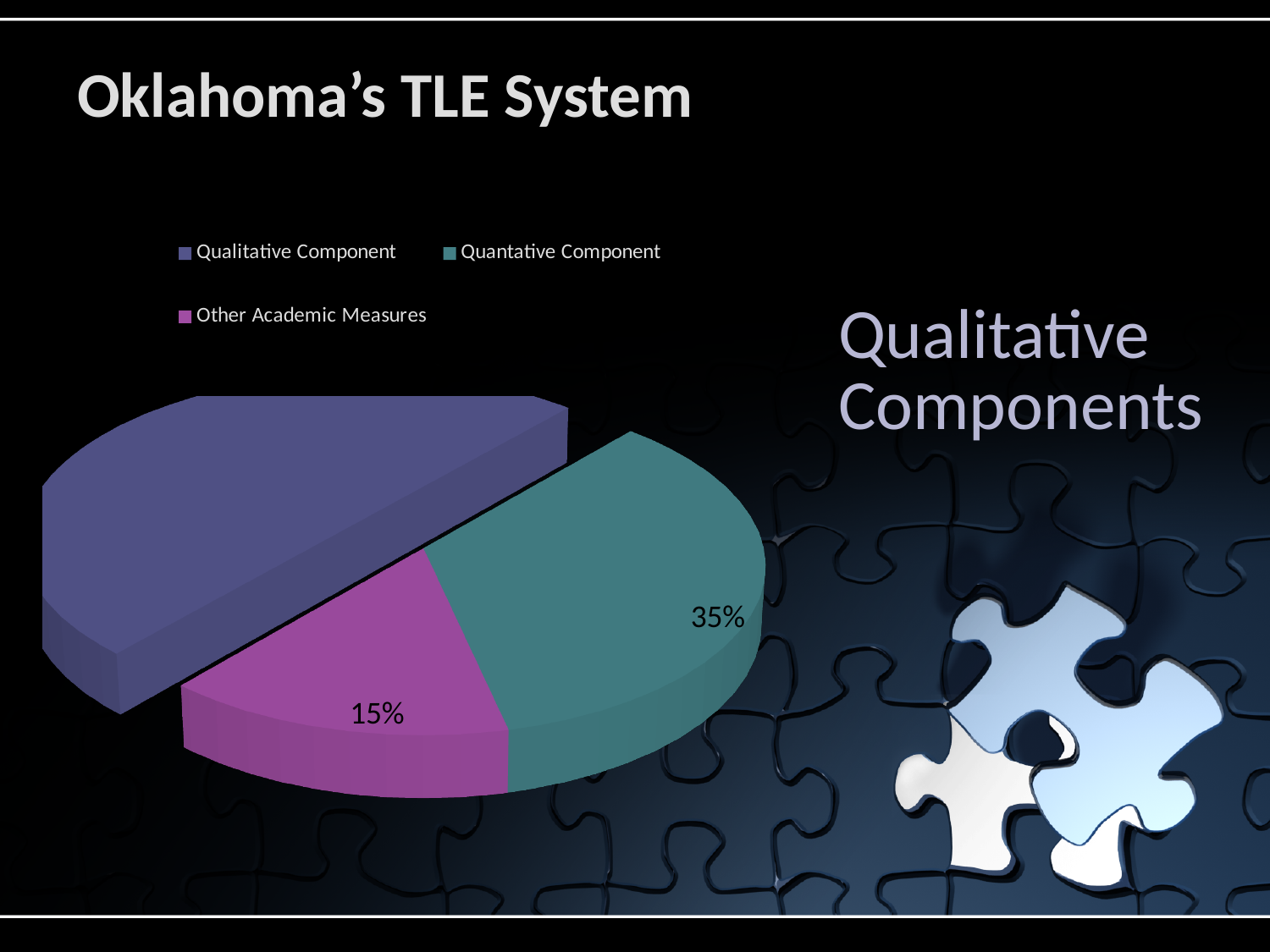
What percentage is shown for the Quantative Component slice? 35% How many entries does the chart legend list? 3 Which slice is the largest in the pie chart? Qualitative Component What percentage is shown for the Other Academic Measures slice? 15% Which slice is the smallest in the pie chart? Other Academic Measures Which is larger, the Quantative Component slice or the Other Academic Measures slice? Quantative Component What is the difference between the Quantative Component and Other Academic Measures percentages? 20% What colour is the Qualitative Component slice? purple What kind of chart is shown on the slide? pie chart How many slices does the pie chart have? 3 What share of the pie does Other Academic Measures take? 15% What is the title of the slide containing the pie chart? Oklahoma's TLE System